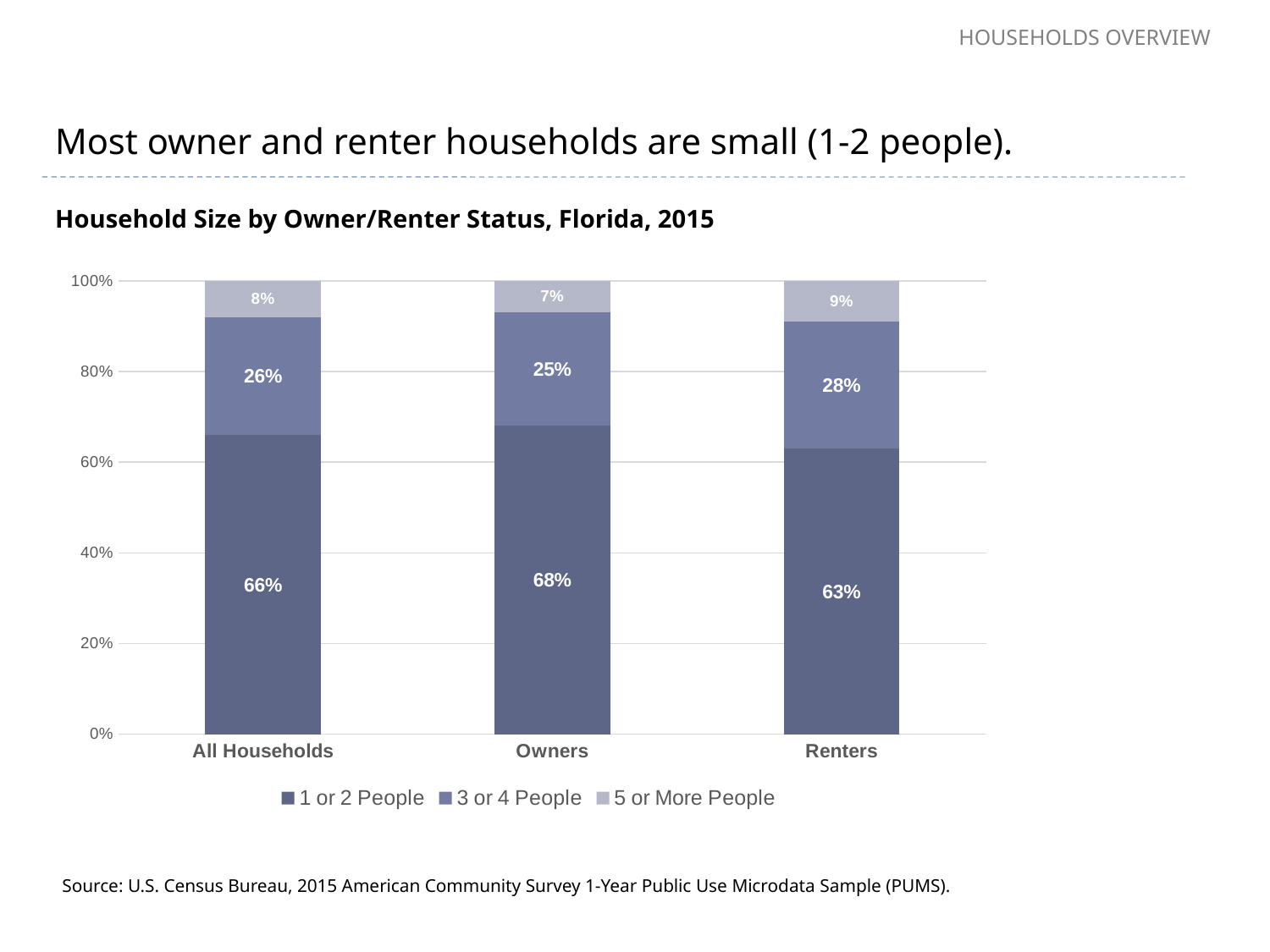
What kind of chart is shown on the slide? Stacked bar chart Which category has the lowest share of 5 or More People households? Owners What is the difference between the 1 or 2 People share for Owners and for Renters? 5% What percentage of All Households have 3 or 4 People? 26% How many categories are shown on the x axis? 3 What percentage of Renters households have 5 or More People? 9% Which category has the highest share of 1 or 2 People households? Owners Which is larger: the 3 or 4 People share for Renters or for Owners? Renters How many series does the legend list? 3 What is the title of the chart? Household Size by Owner/Renter Status, Florida, 2015 What is the combined share of 1 or 2 People and 3 or 4 People households for Renters? 91% What percentage of Owners households have 1 or 2 People? 68%